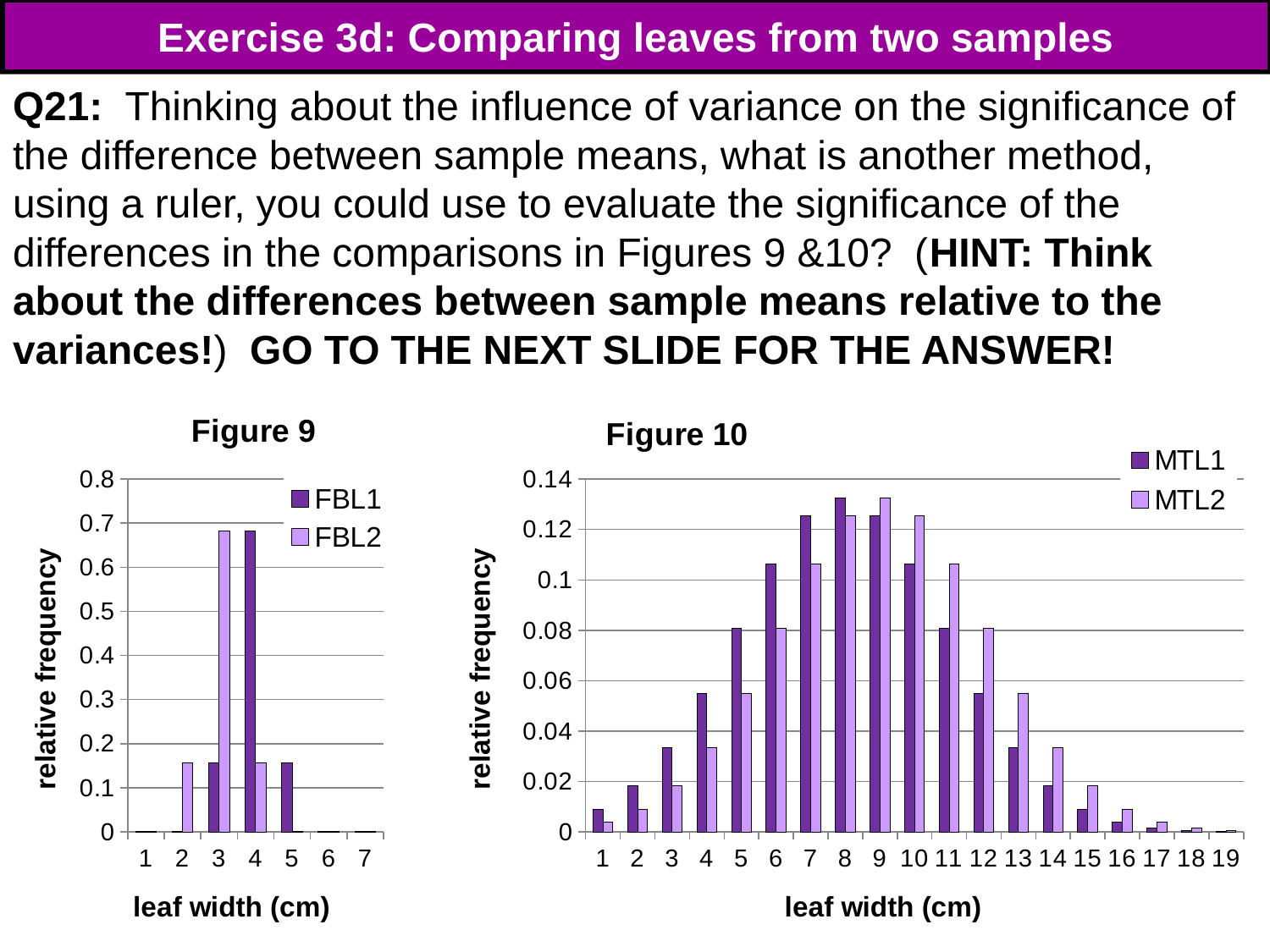
In Figure 9, is the FBL2 value at leaf width 2 greater or less than 0.2? less How many leaf width categories are shown on the x axis of Figure 10? 19 In Figure 10, which leaf width has the highest relative frequency for MTL1? 8 In Figure 9, which leaf width has the highest relative frequency for FBL2? 3 What kind of chart is Figure 9? bar chart How many leaf width categories are shown on the x axis of Figure 9? 7 In Figure 9, which leaf width has the highest relative frequency for FBL1? 4 How many series does the legend of Figure 9 list? 2 In Figure 9, is the FBL1 value at leaf width 4 greater or less than 0.6? greater In Figure 10, at leaf width 4, which series has the larger value, MTL1 or MTL2? MTL1 In Figure 10, is the MTL1 value at leaf width 7 greater or less than 0.12? greater